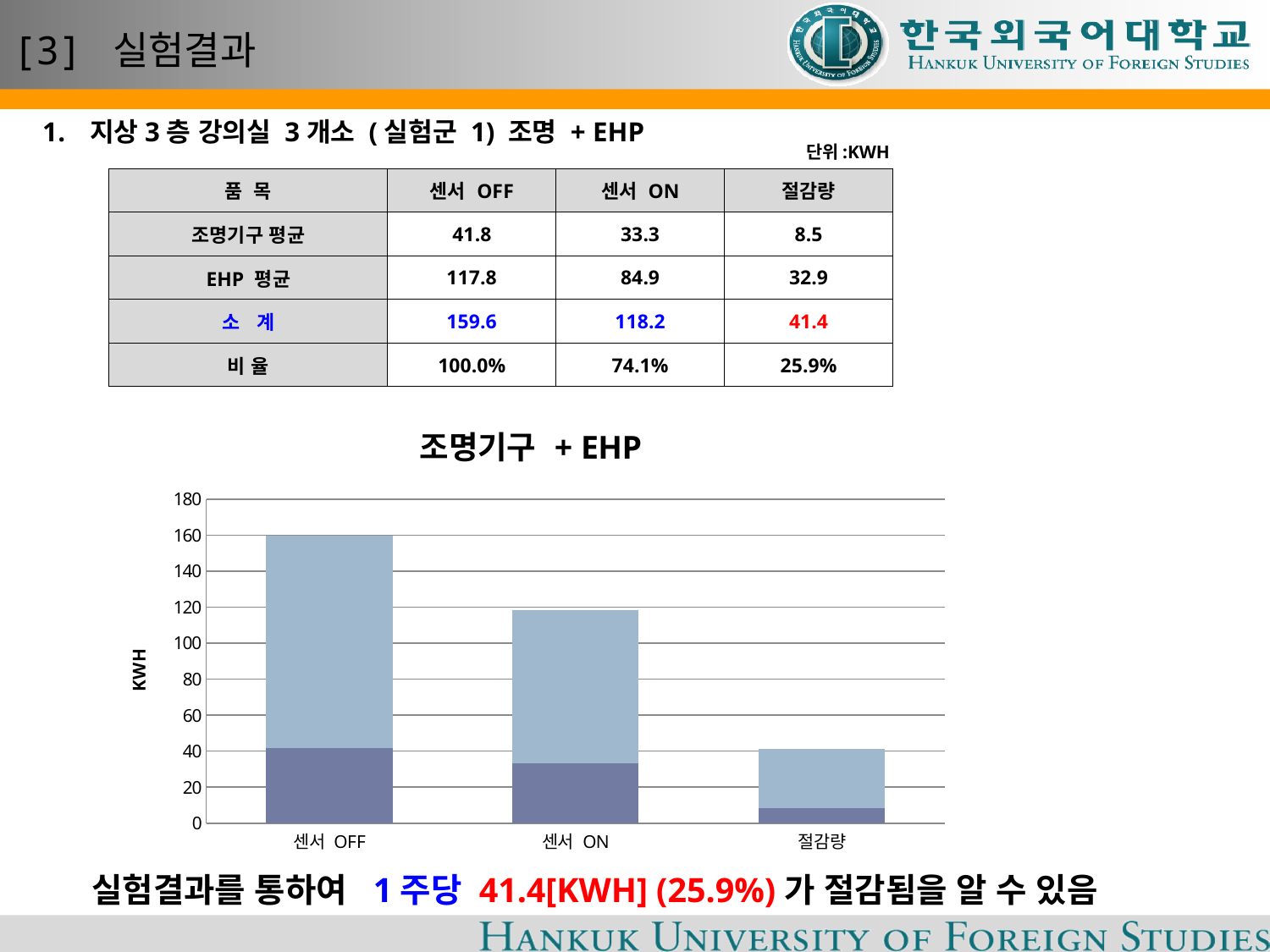
How many categories are shown on the x axis of the chart? 3 What is the title of the chart? 조명기구 + EHP Is the total bar height for 센서 OFF greater or less than 140? greater Do the bar heights rise or fall from left to right across the x axis? fall Is the total bar height for 센서 ON greater or less than 100? greater Is the total bar height for 센서 ON greater or less than 140? less What is the label on the vertical axis of the chart? KWH What kind of chart is shown on the slide? Stacked bar chart Which category has the tallest bar in the chart? 센서 OFF Which bar is taller, 센서 ON or 절감량? 센서 ON Which category has the shortest bar in the chart? 절감량